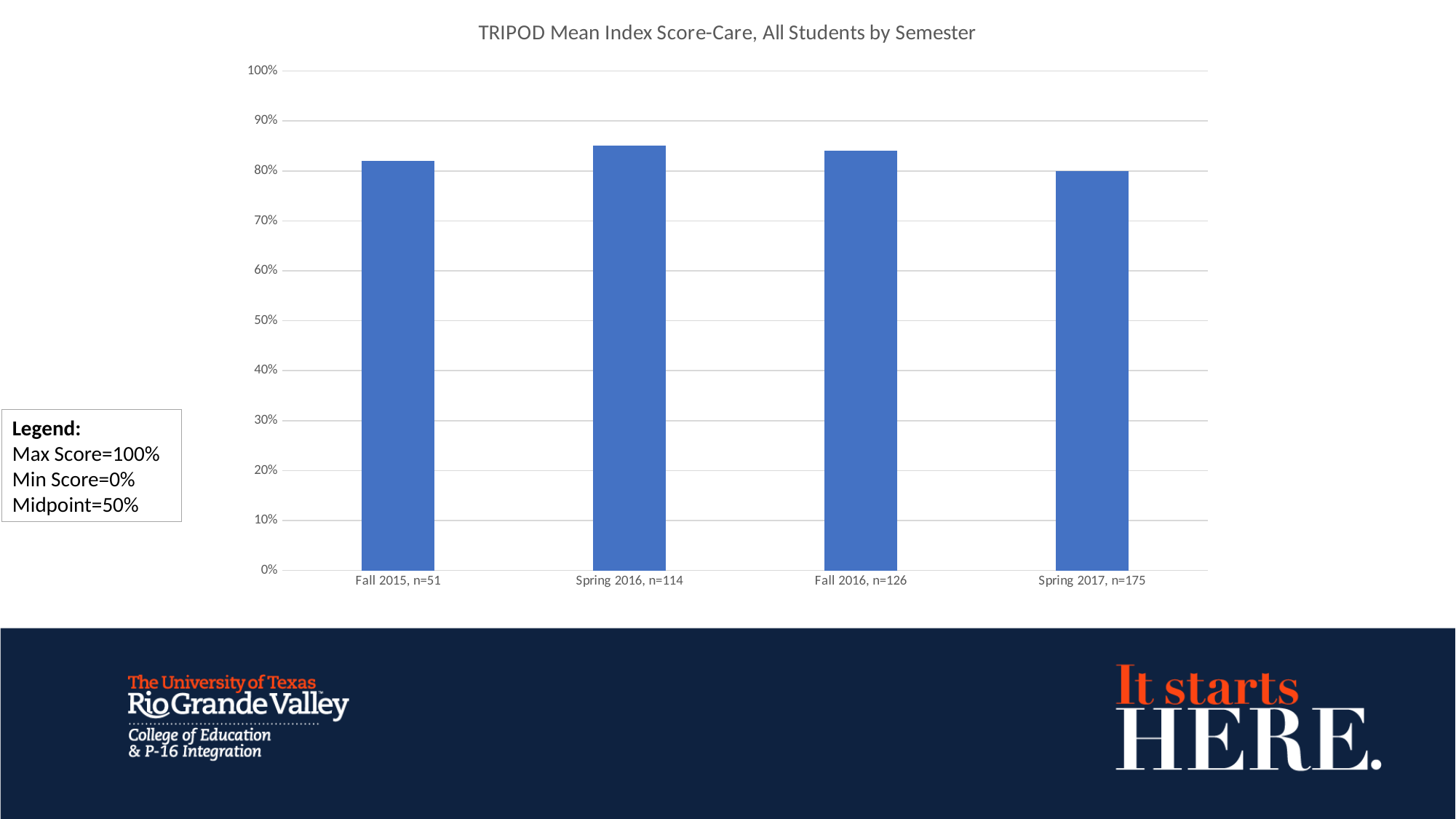
Is the value for Spring 2017, n=175 greater or less than 50%? greater Which is larger, the value for Fall 2015, n=51 or the value for Spring 2017, n=175? Fall 2015, n=51 Is the value for Spring 2016, n=114 greater or less than 90%? less How many semesters are plotted in the chart? 4 Is the value for Fall 2015, n=51 greater or less than 80%? greater Which semester has the lowest mean index score? Spring 2017, n=175 What is the sample size (n) shown for Spring 2017 on the x axis? 175 What kind of chart is shown on the slide? bar chart Which is larger, the value for Spring 2016, n=114 or the value for Fall 2015, n=51? Spring 2016, n=114 What is the title of the chart? TRIPOD Mean Index Score-Care, All Students by Semester